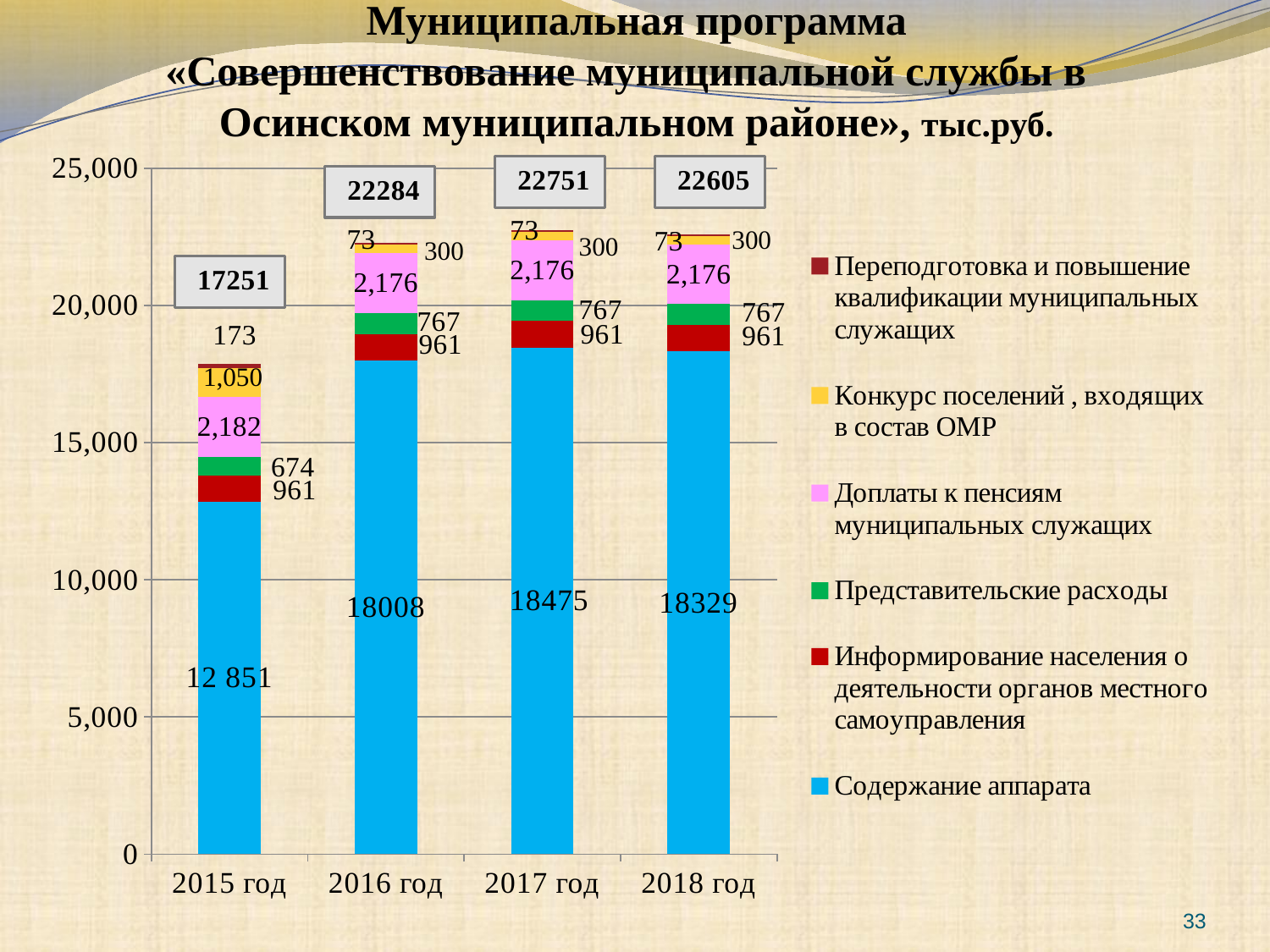
How many series does the legend list? 6 How many years (categories) are shown on the x axis? 4 What is the value of Содержание аппарата for 2017 год? 18475 What is the value of Содержание аппарата for 2015 год? 12 851 What is the value of Конкурс поселений, входящих в состав ОМР for 2016 год? 300 Is the value of Содержание аппарата for 2016 год greater or less than 15,000? greater What is the value of Доплаты к пенсиям муниципальных служащих for 2015 год? 2,182 Which year has the lowest total? 2015 год What type of chart is shown on the slide? stacked bar chart What is the difference between the totals for 2017 год and 2018 год? 146 What is the total of the stacked bar for 2016 год? 22284 Which year has the highest total? 2017 год